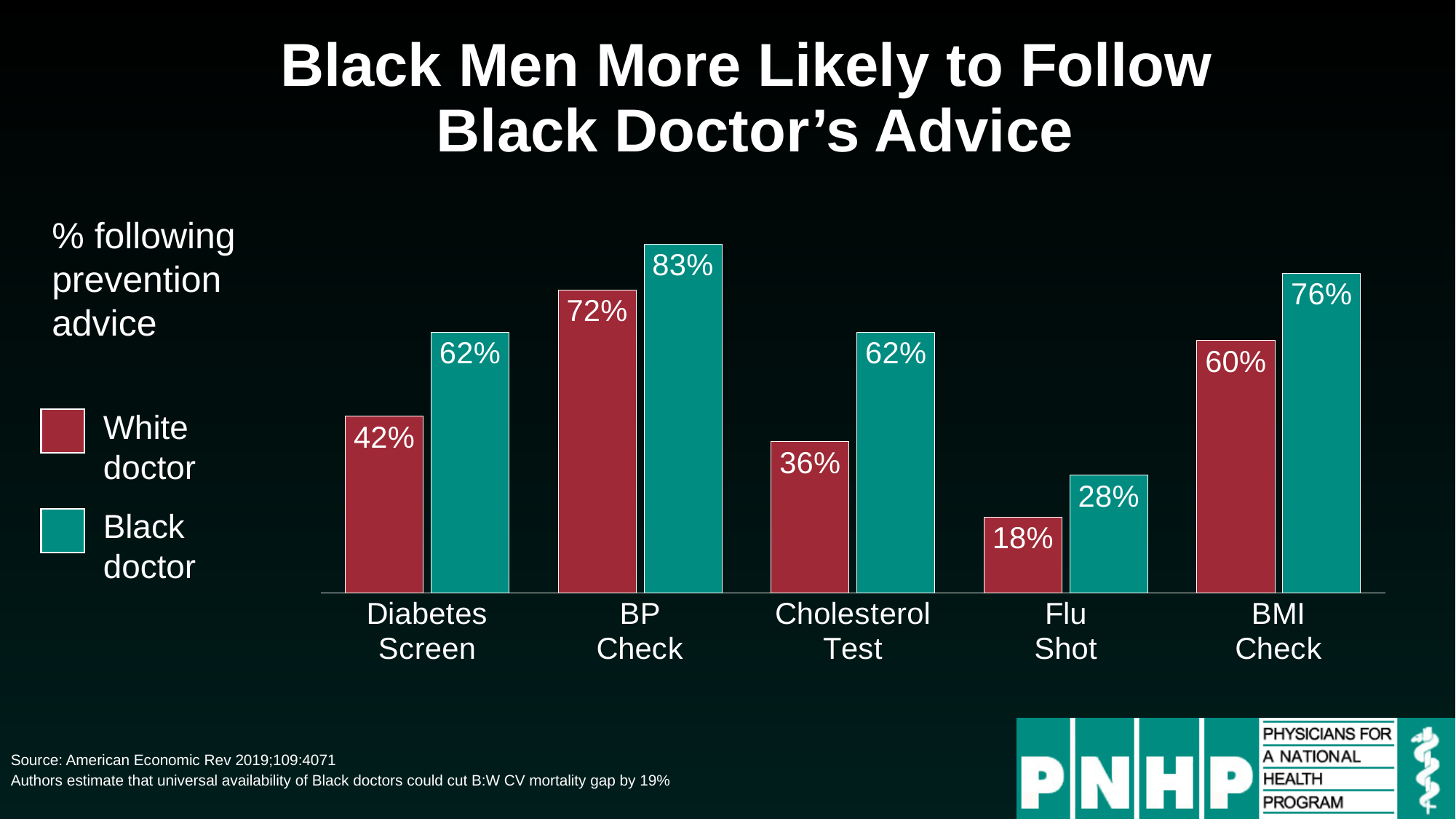
What percentage followed Flu Shot advice from a White doctor? 18% Which is larger: the White doctor value for BP Check or the Black doctor value for BMI Check? Black doctor value for BMI Check Which colour represents the Black doctor series? Teal What kind of chart is shown on the slide? Bar chart What is the difference between the Black doctor and White doctor values for Cholesterol Test? 26% How many series does the legend list? 2 What is the difference between the Black doctor and White doctor values for BP Check? 11% What is the value for BMI Check with a White doctor? 60% How many categories are shown on the x axis? 5 What percentage of Black men followed prevention advice for a Diabetes Screen when seen by a Black doctor? 62% Which category has the lowest value for the White doctor series? Flu Shot Which category has the highest value for the Black doctor series? BP Check